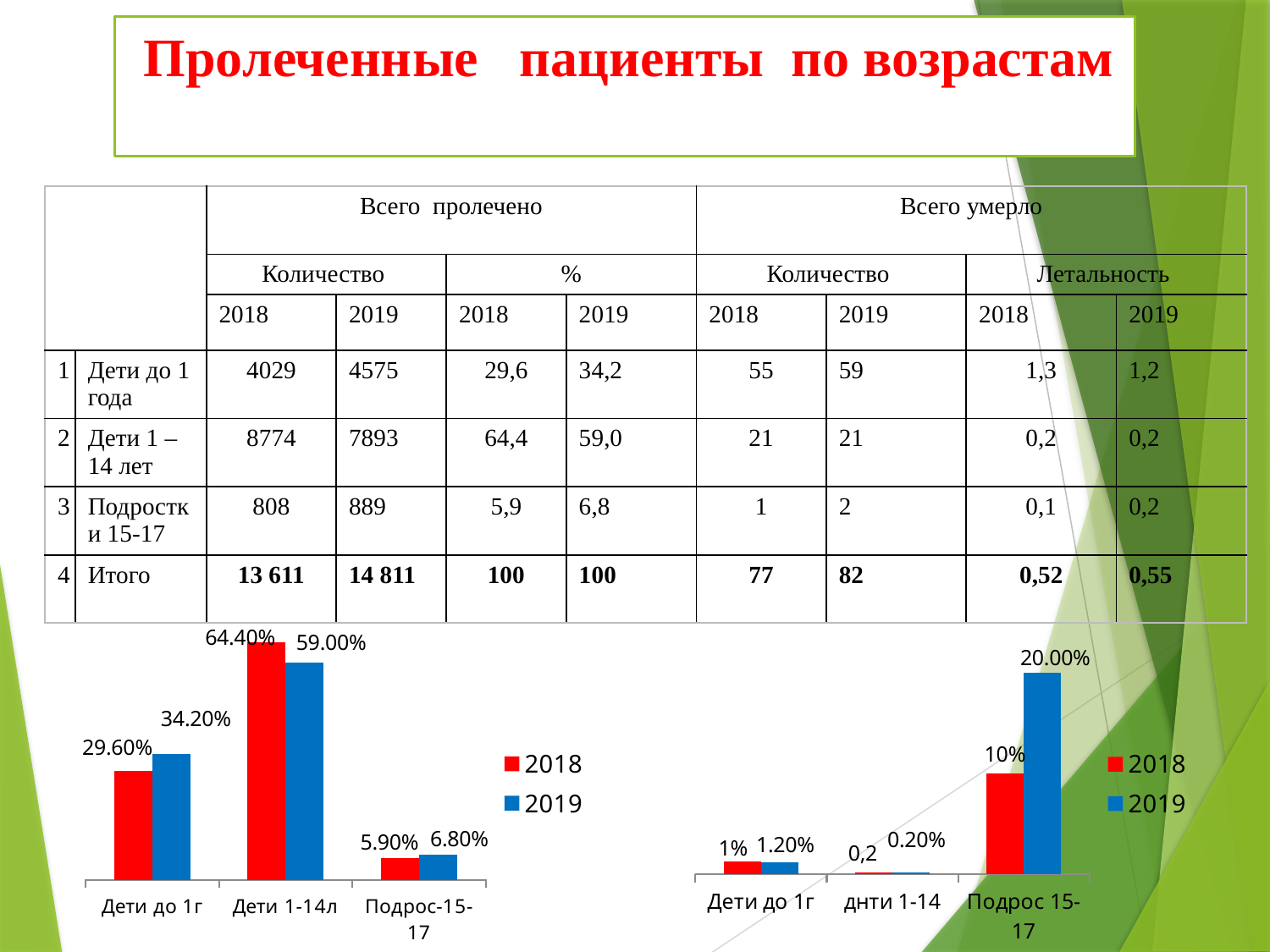
In the left chart, what is the difference between the 2018 and 2019 values for Дети 1-14л? 5.40% In the right chart, what is the 2018 value for Подрос 15-17? 10% How many series does the legend of the right chart list? 2 In the right chart, what is the 2019 value for Подрос 15-17? 20.00% In the right chart, which category has the highest 2019 value? Подрос 15-17 In the left chart, which category has the lowest 2018 value? Подрос-15-17 In the left chart, is the 2018 or the 2019 value larger for Дети до 1г? 2019 What type of chart is the left chart? bar chart In the left chart, what is the 2018 value for Дети 1-14л? 64.40% In the left chart, what is the 2019 value for Подрос-15-17? 6.80% In the left chart, which category has the highest 2019 value? Дети 1-14л In the left chart, what is the 2019 value for Дети до 1г? 34.20%